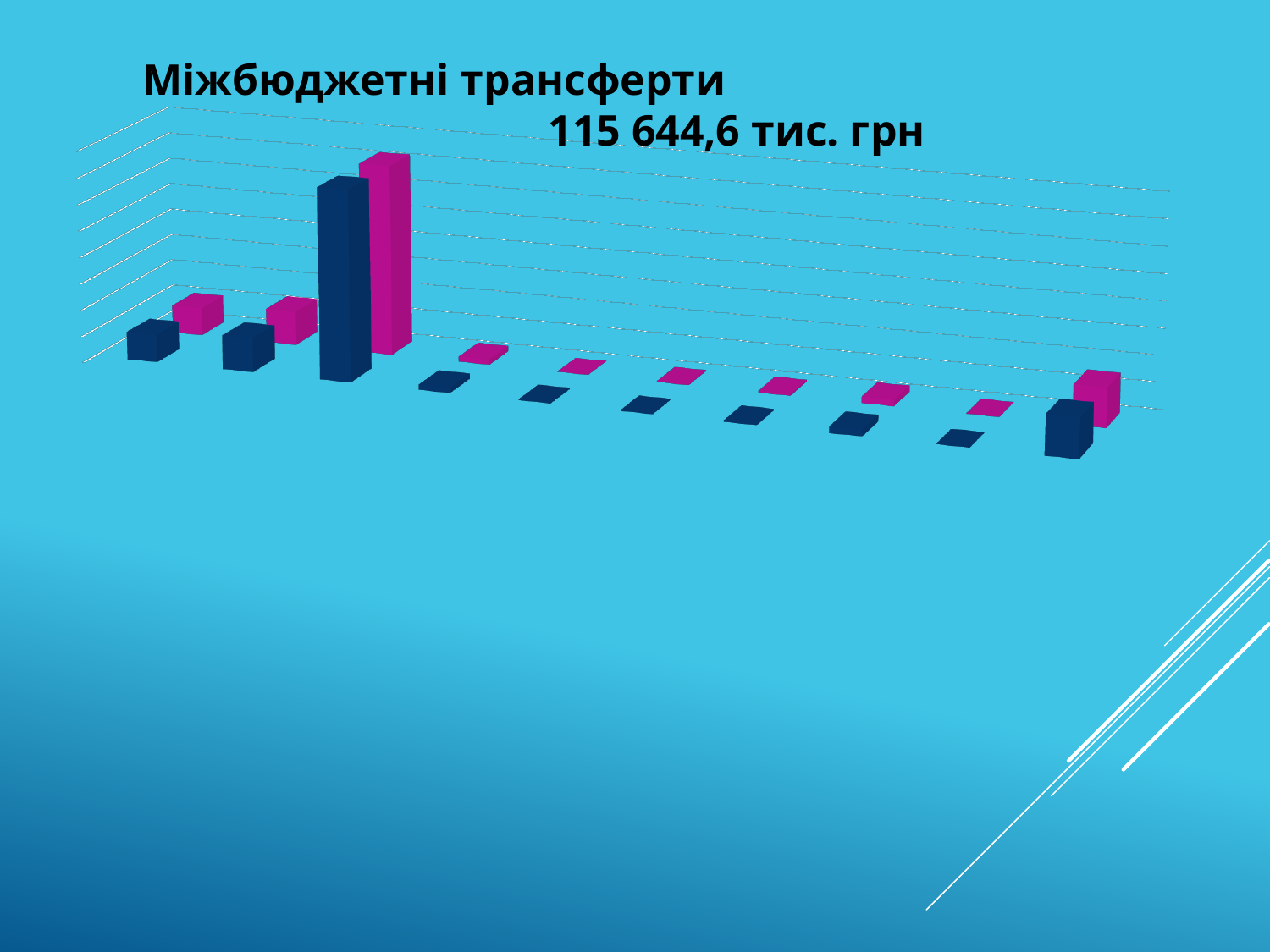
What total amount in thousand UAH is stated in the chart title? 115 644,6 тис. грн What kind of chart is shown on the slide? bar chart Which group of bars, counted from the left, has the tallest bars in the chart? the third group How many groups of bars are plotted in the chart? 10 What is the title of the chart on the slide? Міжбюджетні трансферти 115 644,6 тис. грн How many differently coloured bar series are plotted in the chart? 2